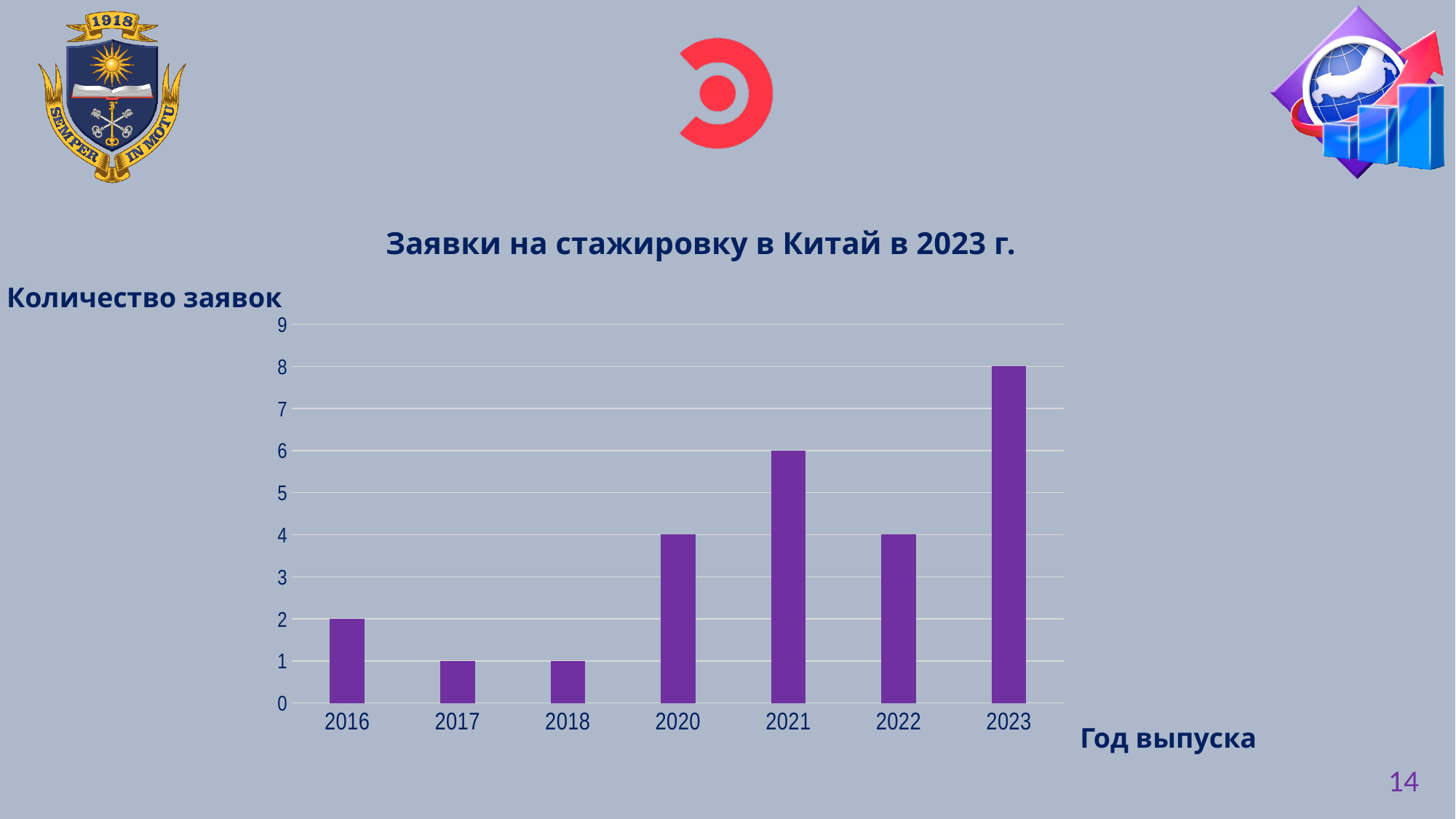
What is the difference in applications between 2020 and 2017? 3 What is the number of applications for 2021? 6 Which year has the highest number of applications? 2023 Is the value for 2023 greater or less than 5? greater What is the title of the chart? Заявки на стажировку в Китай в 2023 г. What is the label of the x axis? Год выпуска What is the difference in applications between 2023 and 2021? 2 Which year has more applications, 2020 or 2021? 2021 What is the number of applications for 2016? 2 What type of chart is shown on the slide? bar chart What is the number of applications for 2023? 8 How many years (categories) are shown on the x axis? 7